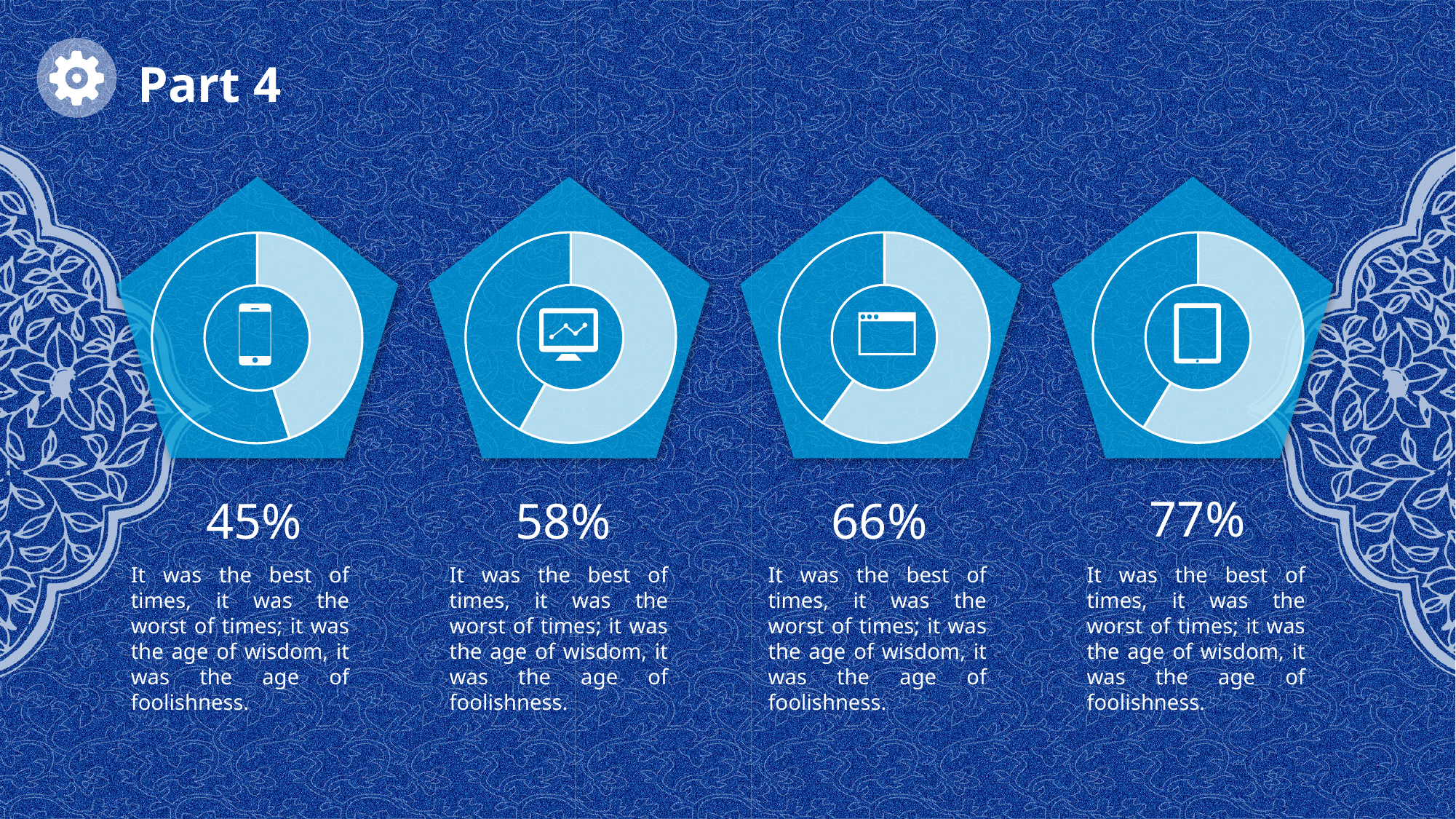
What is the difference between the percentages of the second and third donut charts from the left? 8% What is the difference between the percentage of the rightmost donut chart and the leftmost donut chart? 32% Which donut chart shows the highest percentage? The rightmost chart (tablet icon), 77% What value is shown below the rightmost donut chart (with the tablet icon)? 77% Which donut chart shows the lowest percentage? The leftmost chart (phone icon), 45% How many donut charts are on the slide? 4 Do the percentages increase or decrease from left to right across the four charts? Increase What value is shown below the second donut chart from the left (with the monitor icon)? 58% What value is shown below the third donut chart from the left (with the browser window icon)? 66% Which is larger: the percentage of the monitor-icon chart or the browser-window-icon chart? The browser-window-icon chart (66%) What kind of chart is used for each of the four percentages on the slide? Donut (pie) chart What value is shown below the leftmost donut chart (with the phone icon)? 45%